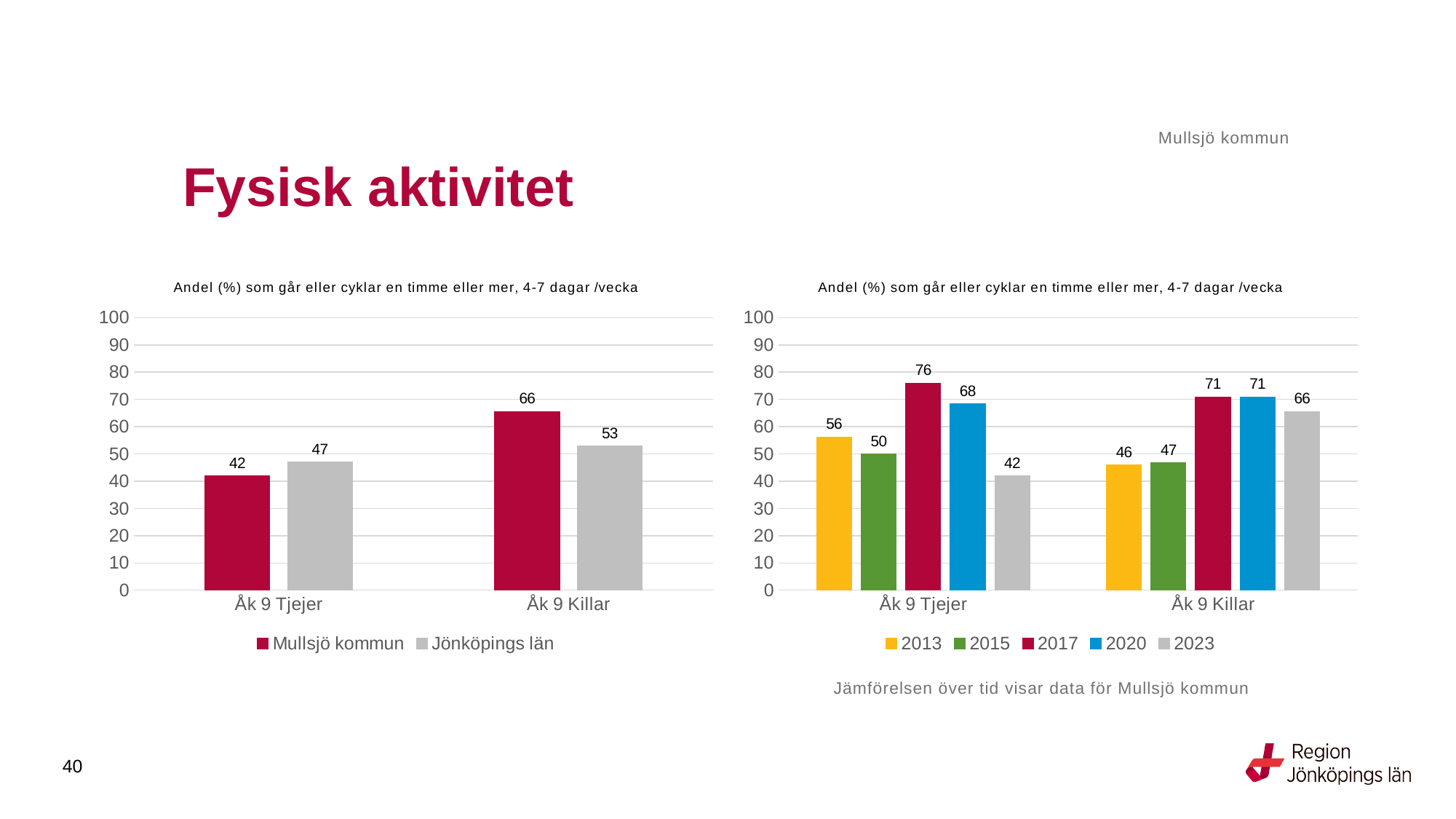
In the left chart, what is the value for Jönköpings län for Åk 9 Tjejer? 47 In the right chart, what is the value for 2017 for Åk 9 Tjejer? 76 In the right chart, is the value for 2013 for Åk 9 Killar greater or less than 50? less How many series does the legend of the right chart list? 5 In the right chart, what is the difference between the 2017 and 2023 values for Åk 9 Tjejer? 34 In the left chart, what is the difference between Mullsjö kommun and Jönköpings län for Åk 9 Killar? 13 In the left chart, which is larger for Åk 9 Tjejer: Mullsjö kommun or Jönköpings län? Jönköpings län In the right chart, what is the value for 2023 for Åk 9 Killar? 66 In the right chart, which year has the lowest value for Åk 9 Tjejer? 2023 How many series does the legend of the left chart list? 2 What kind of chart is the right chart? Bar chart In the left chart, what is the value for Mullsjö kommun for Åk 9 Killar? 66